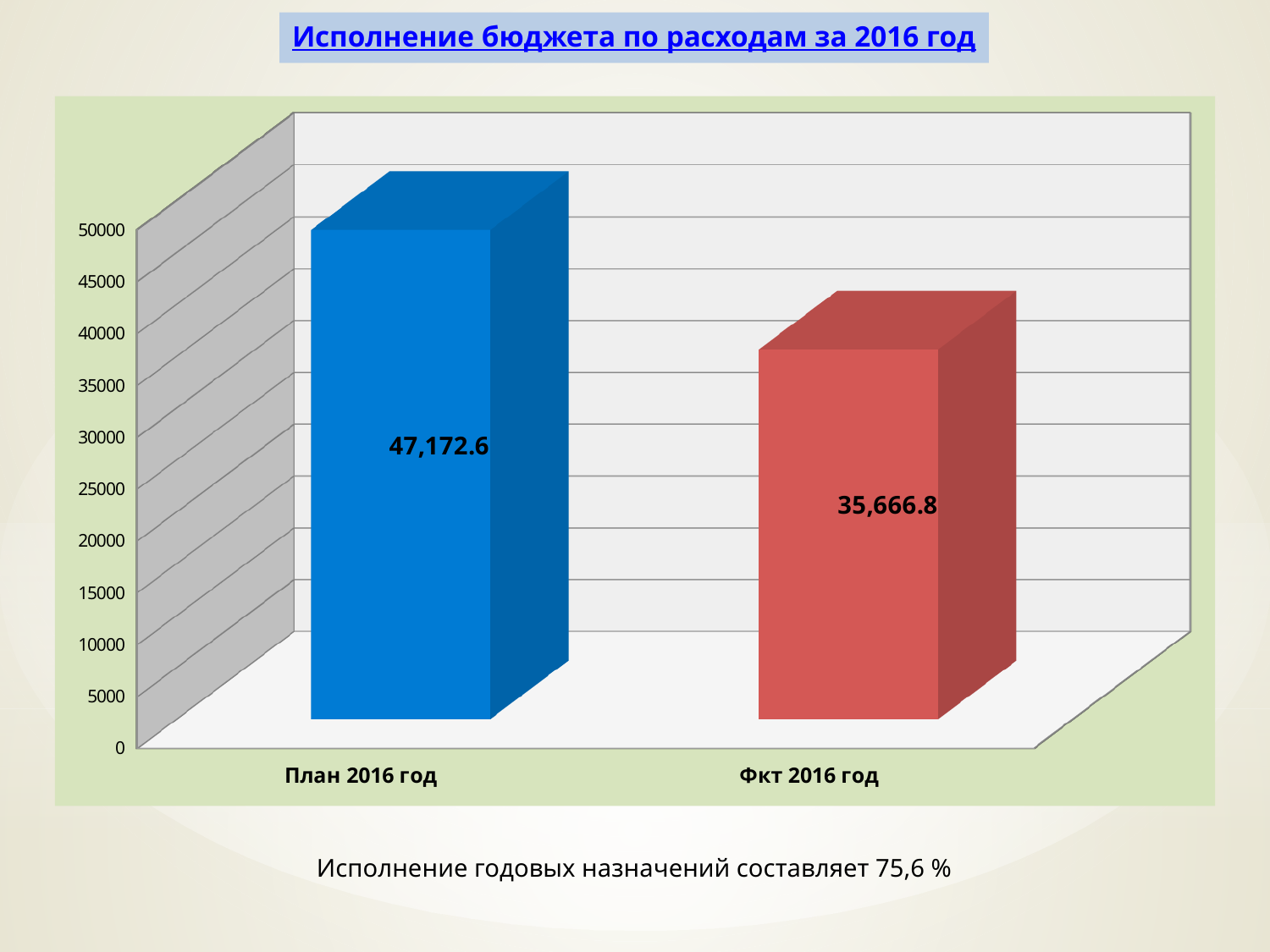
What is the title of the slide? Исполнение бюджета по расходам за 2016 год What kind of chart is shown on the slide? bar chart Is the value for План 2016 год greater or less than 45000? greater What is the value for План 2016 год? 47,172.6 Which category has the highest value? План 2016 год Which category has the lowest value? Фкт 2016 год Which is larger, the value for План 2016 год or the value for Фкт 2016 год? План 2016 год What colour is the bar for Фкт 2016 год? red What is the value for Фкт 2016 год? 35,666.8 Is the value for Фкт 2016 год greater or less than 40000? less What is the difference between the values for План 2016 год and Фкт 2016 год? 11,505.8 How many categories are shown on the chart? 2